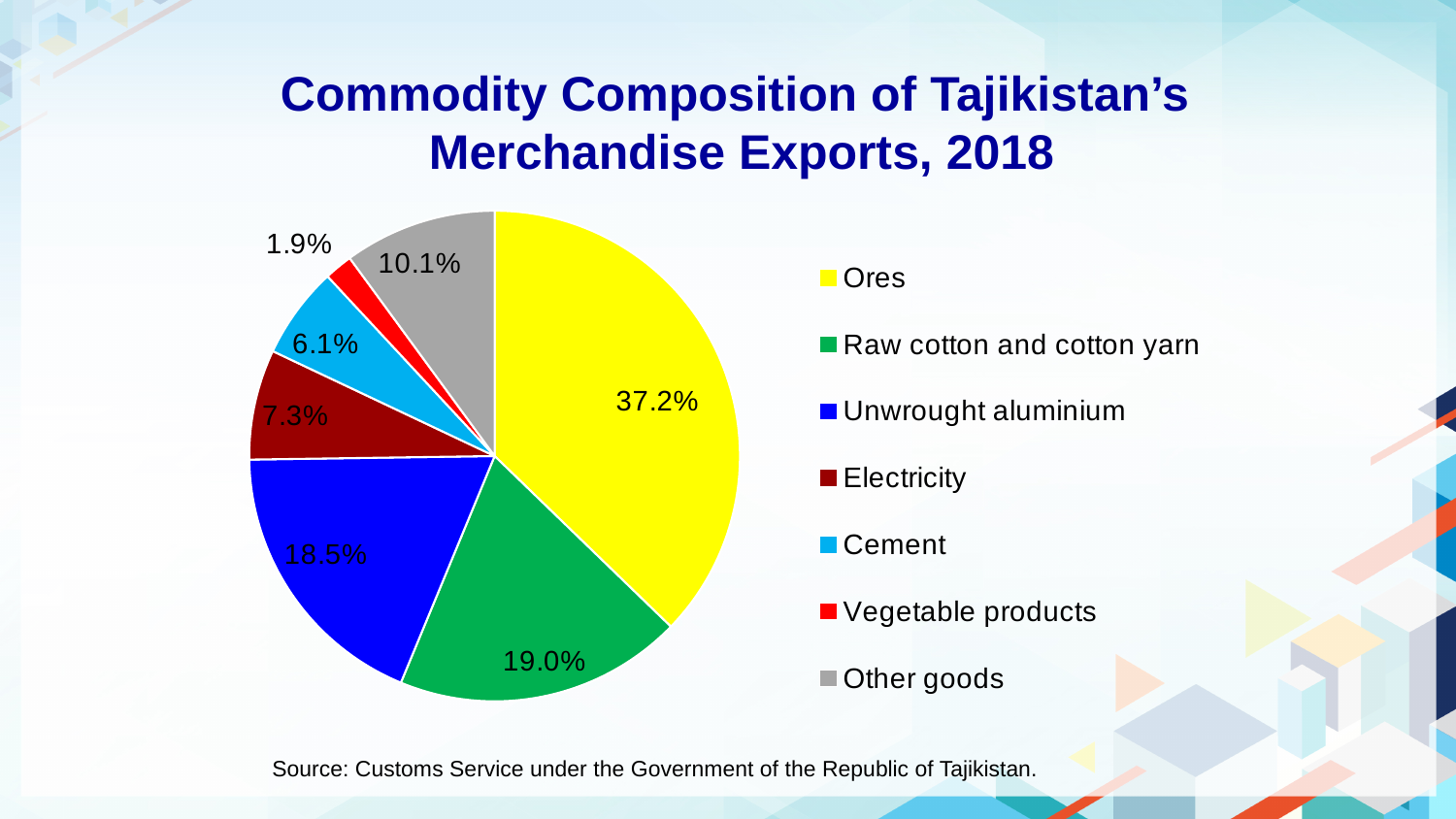
Which colour represents Cement in the pie chart? Light blue Which has a larger share, Cement or Other goods? Other goods What share of Tajikistan's merchandise exports in 2018 is Ores? 37.2% How many commodity categories are shown in the pie chart? 7 What is the difference in percentage points between Ores and Raw cotton and cotton yarn? 18.2 What share does Electricity have in the pie chart? 7.3% What type of chart is shown on the slide? Pie chart What is the value shown for Vegetable products? 1.9% Which commodity has the largest share of merchandise exports? Ores What percentage of the pie is Unwrought aluminium? 18.5% What is the combined share of Raw cotton and cotton yarn and Unwrought aluminium? 37.5% Which commodity has the smallest share of merchandise exports? Vegetable products